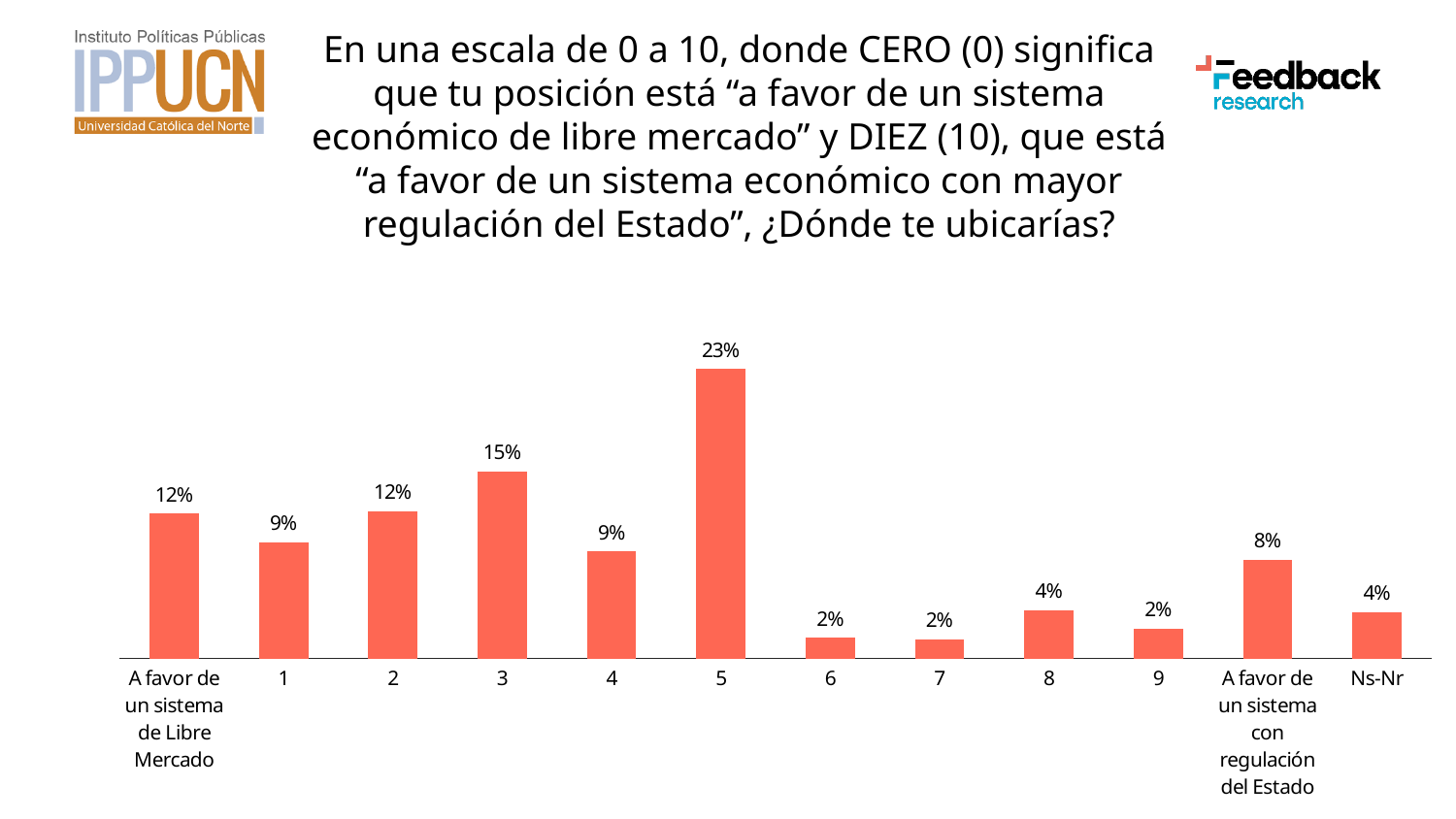
What is the value for the category "A favor de un sistema de Libre Mercado"? 12% What is the value for 3 on the scale? 15% What is the difference between the value for 5 and the value for 3? 8% What is the value for the category "A favor de un sistema con regulación del Estado"? 8% What kind of chart is shown on the slide? Bar chart Which category has the highest value? 5 What is the value for Ns-Nr? 4% Which is larger, the value for 2 or the value for 4? 2 Which is larger, the value for 8 or the value for 9? 8 What is the difference between the value for "A favor de un sistema de Libre Mercado" and the value for "A favor de un sistema con regulación del Estado"? 4% How many categories are shown on the x axis? 12 What percentage of respondents chose 5 on the scale? 23%